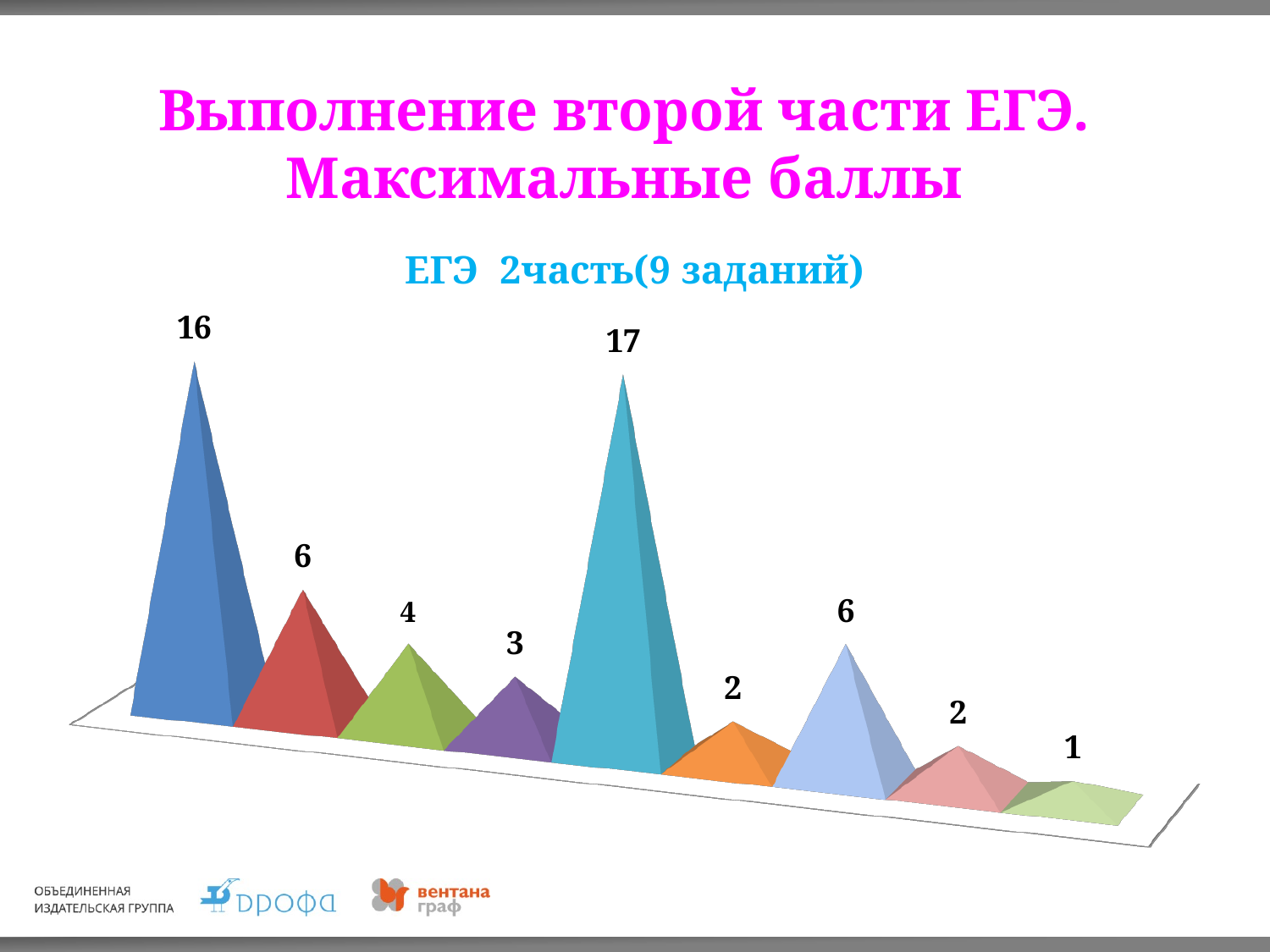
What is the value of the fifth (teal) bar from the left? 17 What is the value of the first (leftmost, dark blue) bar? 16 What is the difference between the fifth bar (17) and the first bar (16)? 1 What is the lowest value shown in the chart? 1 Which is larger: the value of the second (red) bar or the value of the third (green) bar? the second (red) bar, 6 What is the sum of all nine values shown in the chart? 57 What kind of chart is shown on the slide? bar chart What is the highest value shown in the chart? 17 How many bars (data points) are plotted in the chart? 9 What is the value of the last (rightmost, light green) bar? 1 What is the title of the chart on the slide? ЕГЭ 2часть(9 заданий) What is the value of the fourth (purple) bar from the left? 3